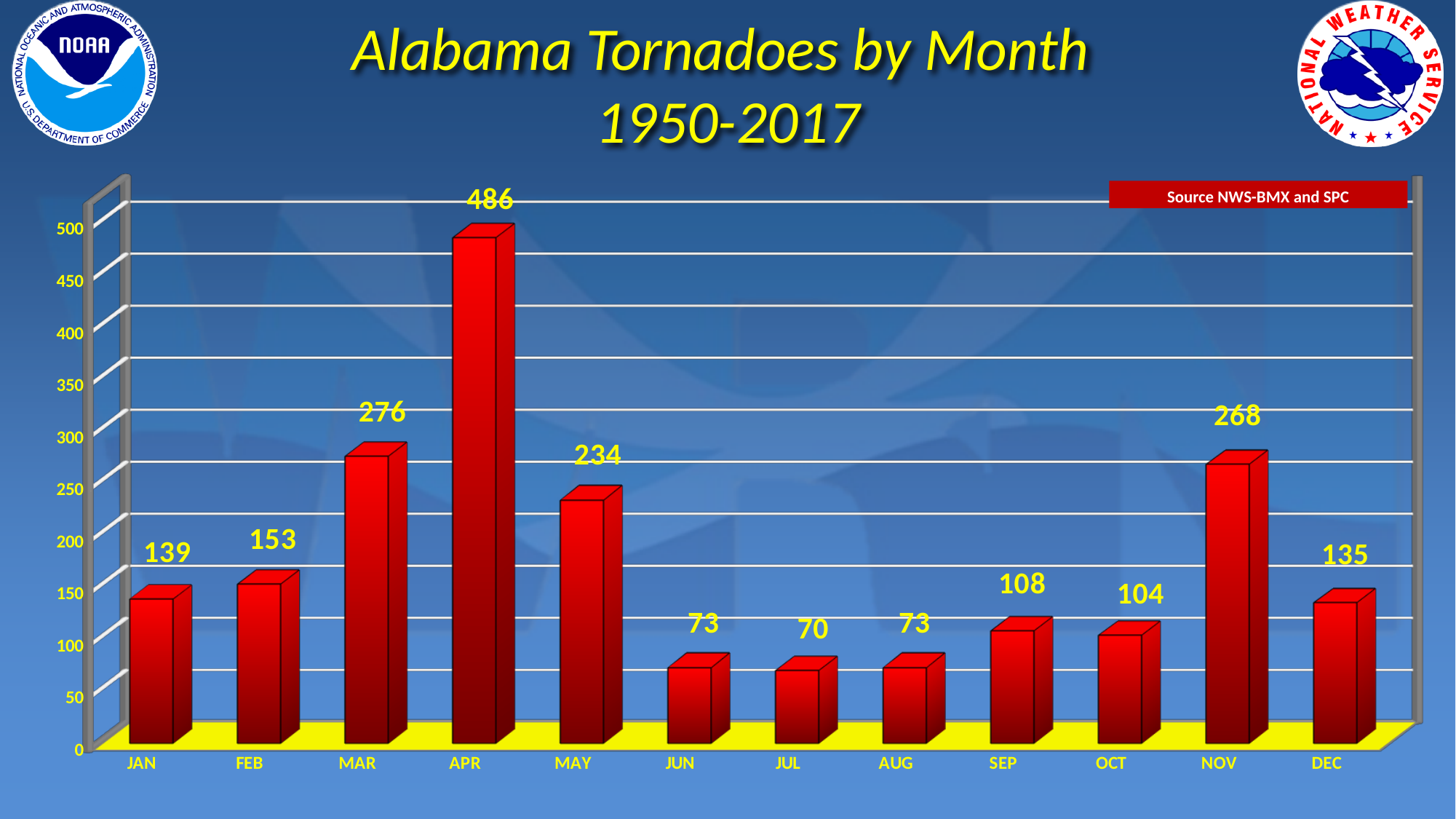
What is the difference between the values for NOV and DEC? 133 Which month has the highest number of tornadoes? APR How many months are shown on the x axis? 12 What is the value for NOV? 268 Is the value for SEP greater or less than 100? greater What is the difference between the values for APR and MAR? 210 What is the value for APR? 486 What is the title of the chart? Alabama Tornadoes by Month 1950-2017 What is the value for JUL? 70 What kind of chart is shown on the slide? bar chart Which is larger, the value for MAR or the value for MAY? MAR Which month has the lowest number of tornadoes? JUL